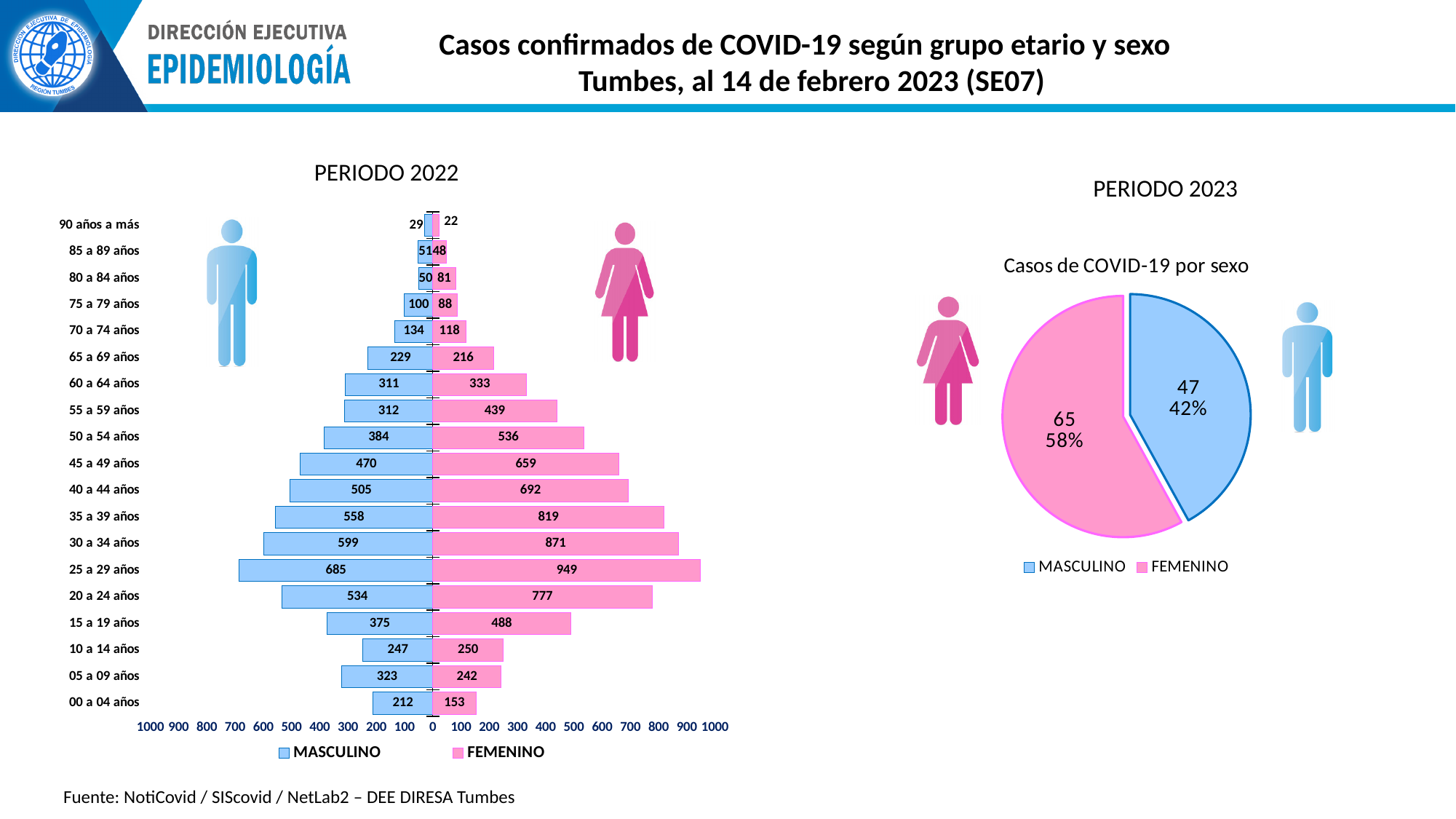
In the PERIODO 2022 chart, what is the MASCULINO value for 25 a 29 años? 685 What kind of chart is the PERIODO 2022 chart? Bar chart In the PERIODO 2022 chart, what is the difference between the FEMENINO and MASCULINO values for 25 a 29 años? 264 In the PERIODO 2022 chart, what is the FEMENINO value for 30 a 34 años? 871 In the PERIODO 2022 chart, which age group has the lowest MASCULINO value? 90 años a más In the PERIODO 2022 chart, how many series does the legend list? 2 In the PERIODO 2022 chart, how many age groups are shown? 19 In the PERIODO 2023 pie chart, what is the total of the MASCULINO and FEMENINO values? 112 In the PERIODO 2023 pie chart, what is the MASCULINO value? 47 In the PERIODO 2022 chart, which is larger for 00 a 04 años, MASCULINO or FEMENINO? MASCULINO In the PERIODO 2022 chart, which age group has the highest FEMENINO value? 25 a 29 años In the PERIODO 2023 pie chart, what share of cases is FEMENINO? 58%